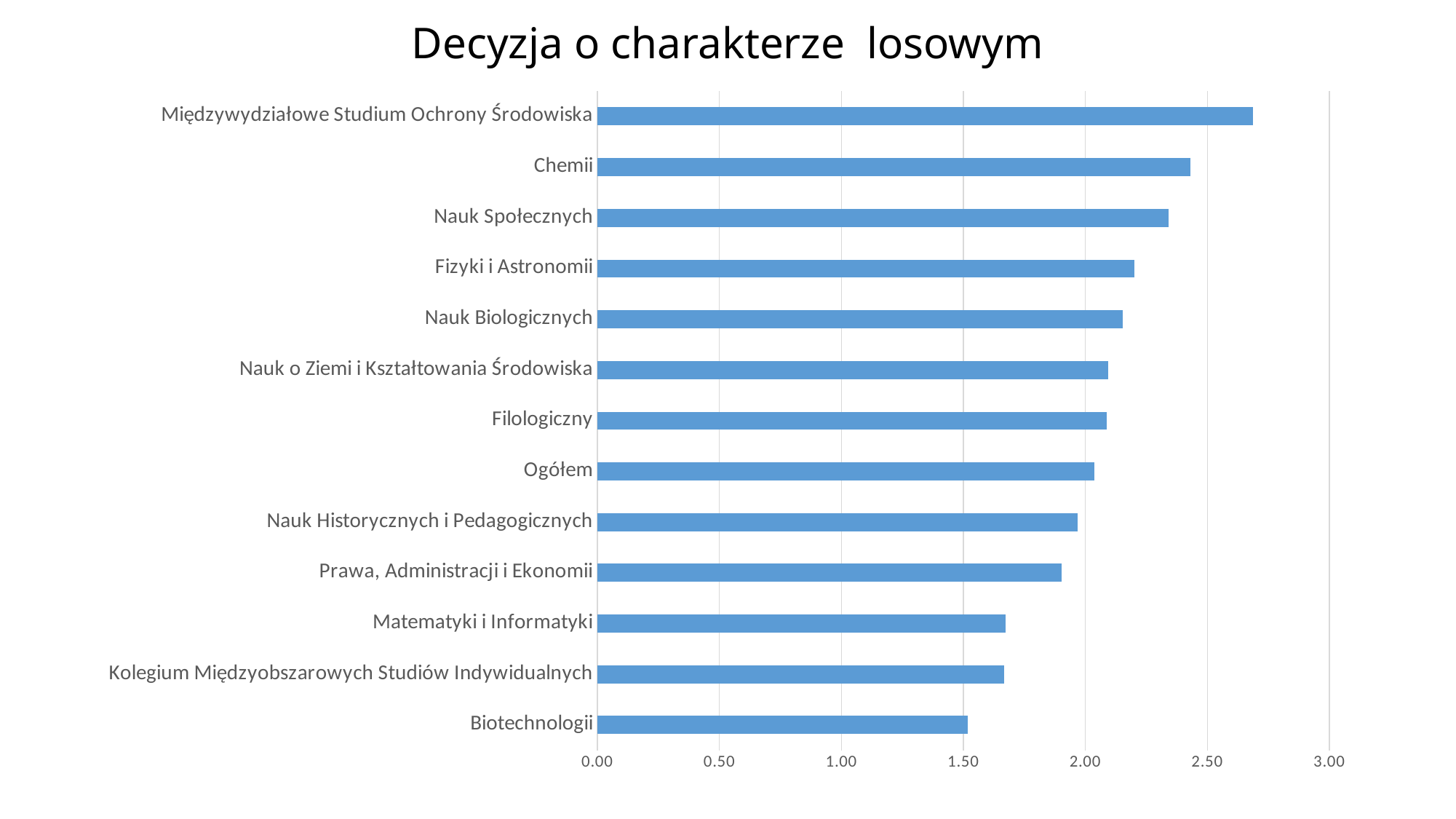
Which category has the highest value? Międzywydziałowe Studium Ochrony Środowiska Is the value for Chemii greater or less than 2.00? greater Is the value for Nauk Społecznych greater or less than 2.00? greater What is the title of the chart? Decyzja o charakterze losowym Is the value for Międzywydziałowe Studium Ochrony Środowiska greater or less than 2.50? greater Which has the larger value, Fizyki i Astronomii or Prawa, Administracji i Ekonomii? Fizyki i Astronomii How many categories are plotted in the chart? 13 Which has the larger value, Chemii or Biotechnologii? Chemii Which category has the lowest value? Biotechnologii What kind of chart is shown on the slide? bar chart